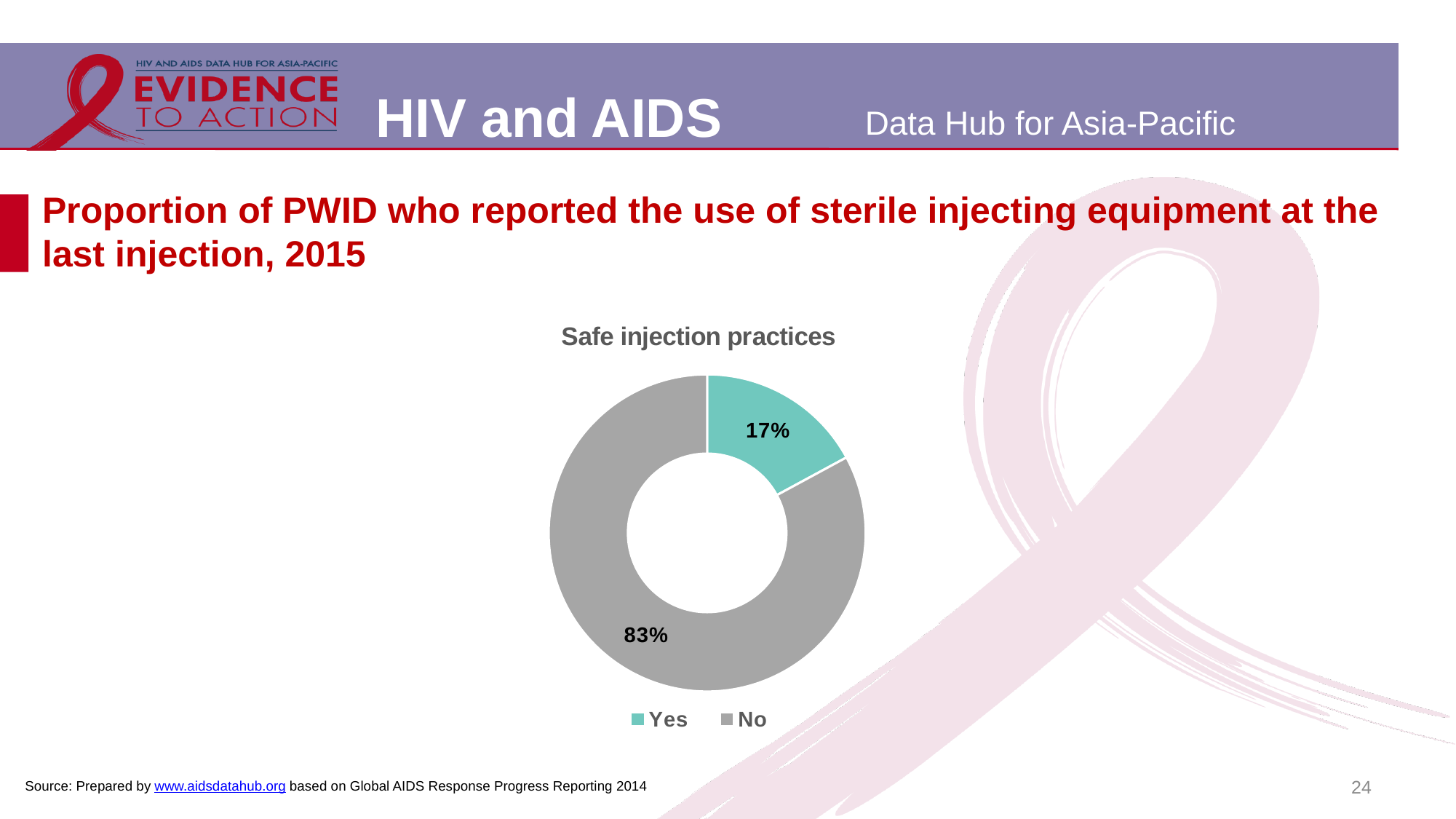
What colour is the 'Yes' slice in the chart? Teal Which slice is larger, 'Yes' or 'No'? No What share of the chart does the 'Yes' slice represent? 17% How many categories does the chart show? 2 Which category has the largest share in the chart? No What is the difference in percentage points between the 'No' and 'Yes' slices? 66 What percentage of the donut chart is labelled 'Yes'? 17% What type of chart is shown on the slide? Donut (pie) chart What percentage of the donut chart is labelled 'No'? 83% Which category has the smallest share in the chart? Yes What is the title of the chart? Safe injection practices